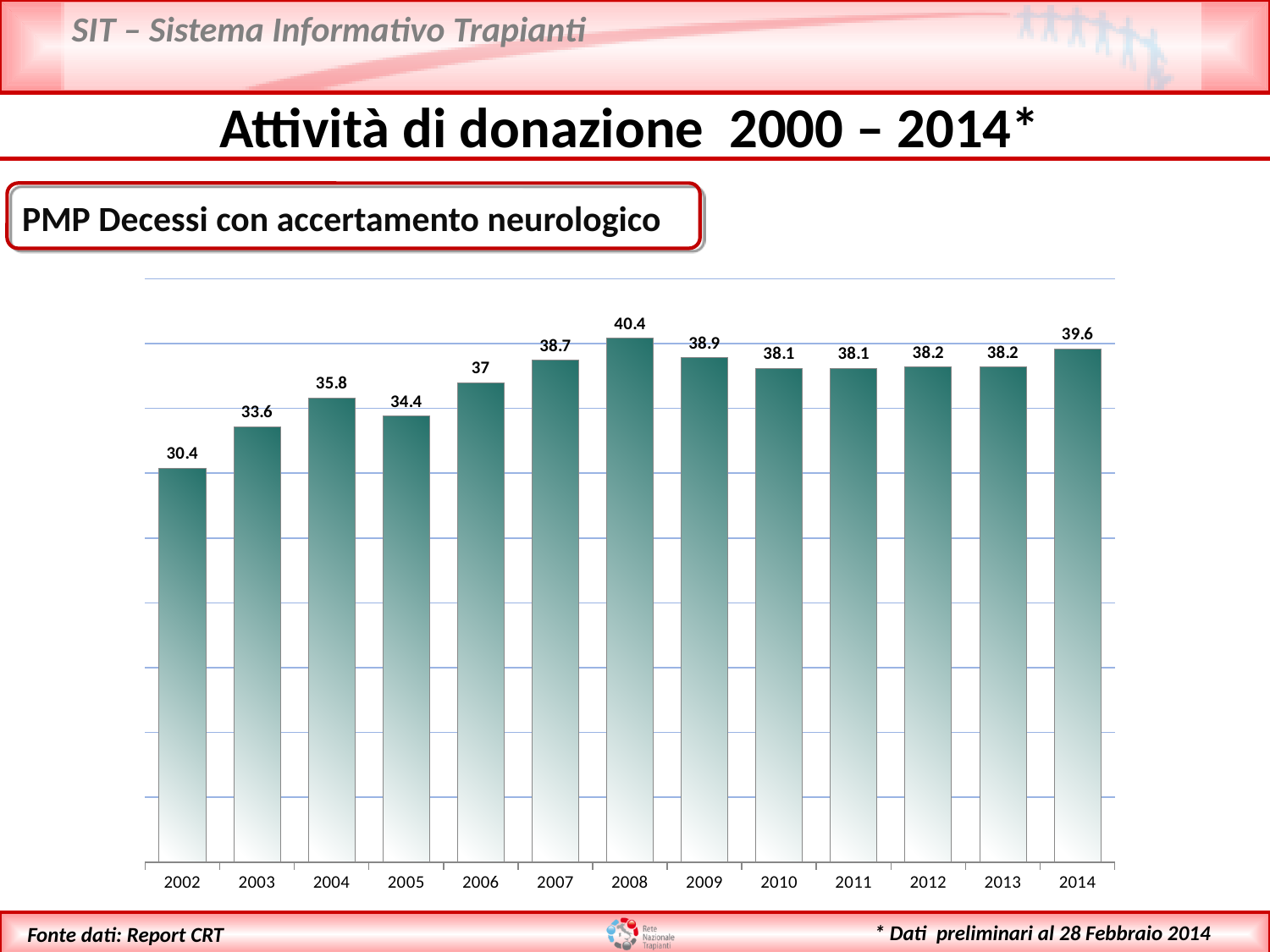
What is the difference between the values for 2014 and 2013? 1.4 What is the value for 2008? 40.4 How many years are shown on the x axis? 13 Which is larger, the value for 2004 or the value for 2005? 2004 What kind of chart is shown on the slide? bar chart What is the value for 2006? 37 What is the difference between the values for 2008 and 2002? 10 What is the value for 2002? 30.4 What is the title shown in the box above the chart? PMP Decessi con accertamento neurologico Which year has the lowest value? 2002 What is the value for 2014? 39.6 Which year has the highest value? 2008